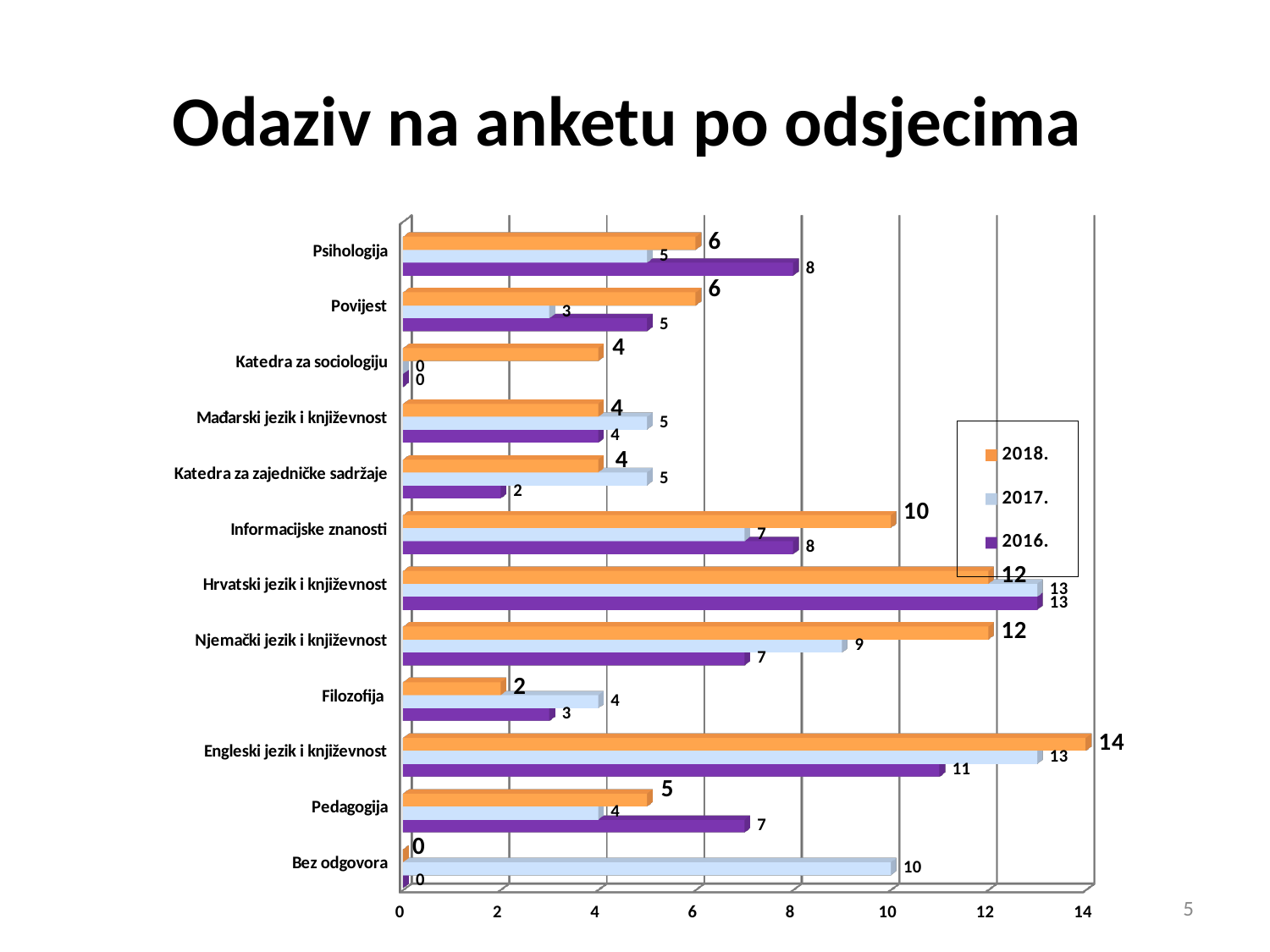
Which category has the lowest value in the 2018. series? Bez odgovora Which is larger for Psihologija: the 2018. value or the 2016. value? 2016. Which category has the highest value in the 2018. series? Engleski jezik i književnost What is the difference between the 2018. and 2016. values for Njemački jezik i književnost? 5 What is the value for Engleski jezik i književnost in the 2018. series? 14 What kind of chart is shown on the slide? bar chart What is the value for Informacijske znanosti in the 2017. series? 7 What is the title of the slide? Odaziv na anketu po odsjecima How many categories are shown on the chart? 12 What is the value for Pedagogija in the 2016. series? 7 How many series does the legend list? 3 What is the value for Bez odgovora in the 2017. series? 10